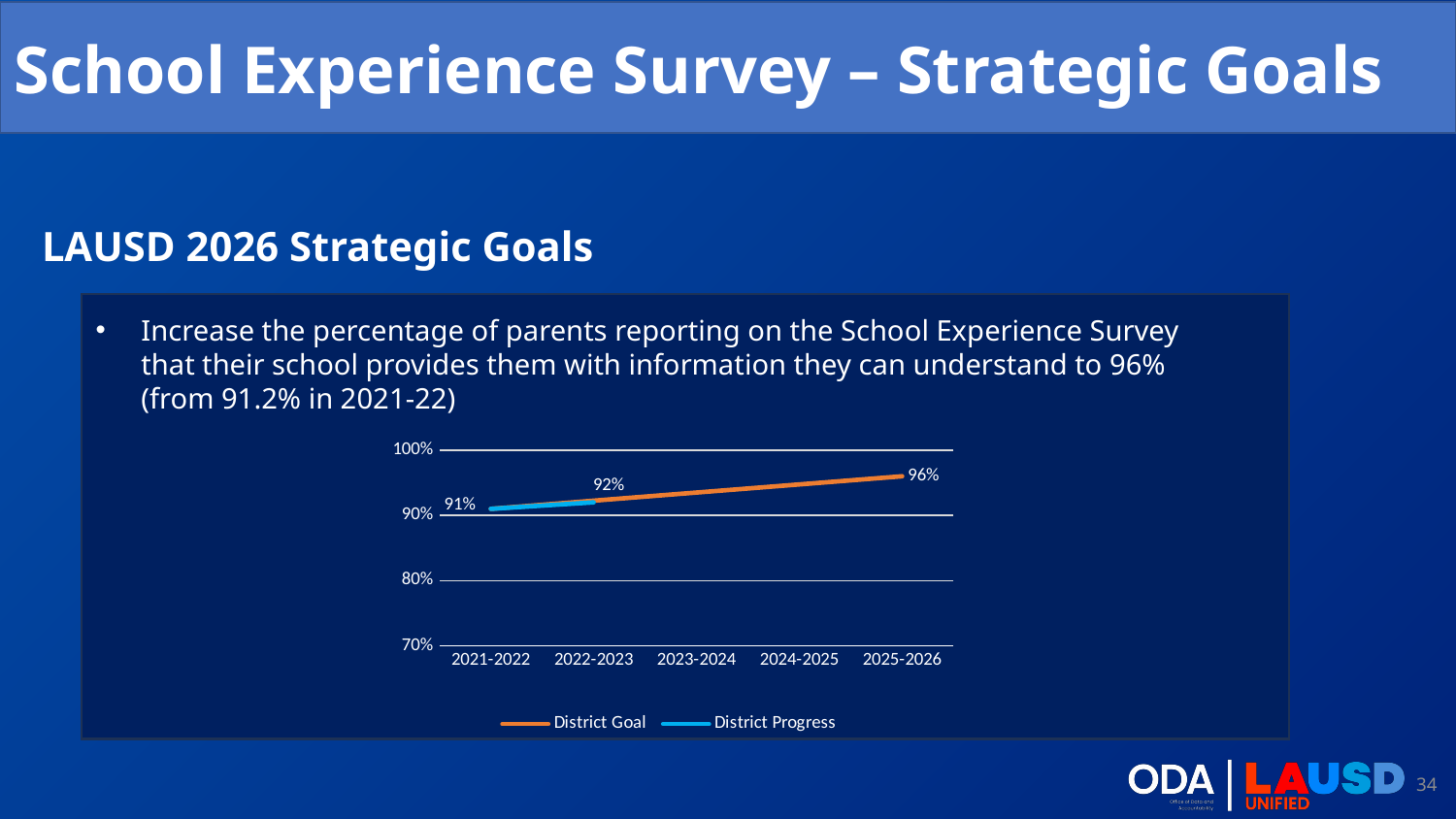
What value is labelled for 2021-2022 in the chart? 91% What are the two series named in the chart legend? District Goal and District Progress What is the District Goal value labelled for 2025-2026 in the chart? 96% What value is labelled for 2022-2023 in the chart? 92% What is the difference between the 2025-2026 goal value and the 2021-2022 value in the chart? 5% How many school years are shown on the x axis of the chart? 5 Is the value for 2021-2022 greater or less than 90%? greater Which is larger in the chart, the value for 2025-2026 or the value for 2021-2022? 2025-2026 How many series does the chart legend list? 2 What colour is the District Goal line in the chart? orange Does the District Goal line rise or fall from 2021-2022 to 2025-2026? rise What type of chart is shown on the slide? line chart